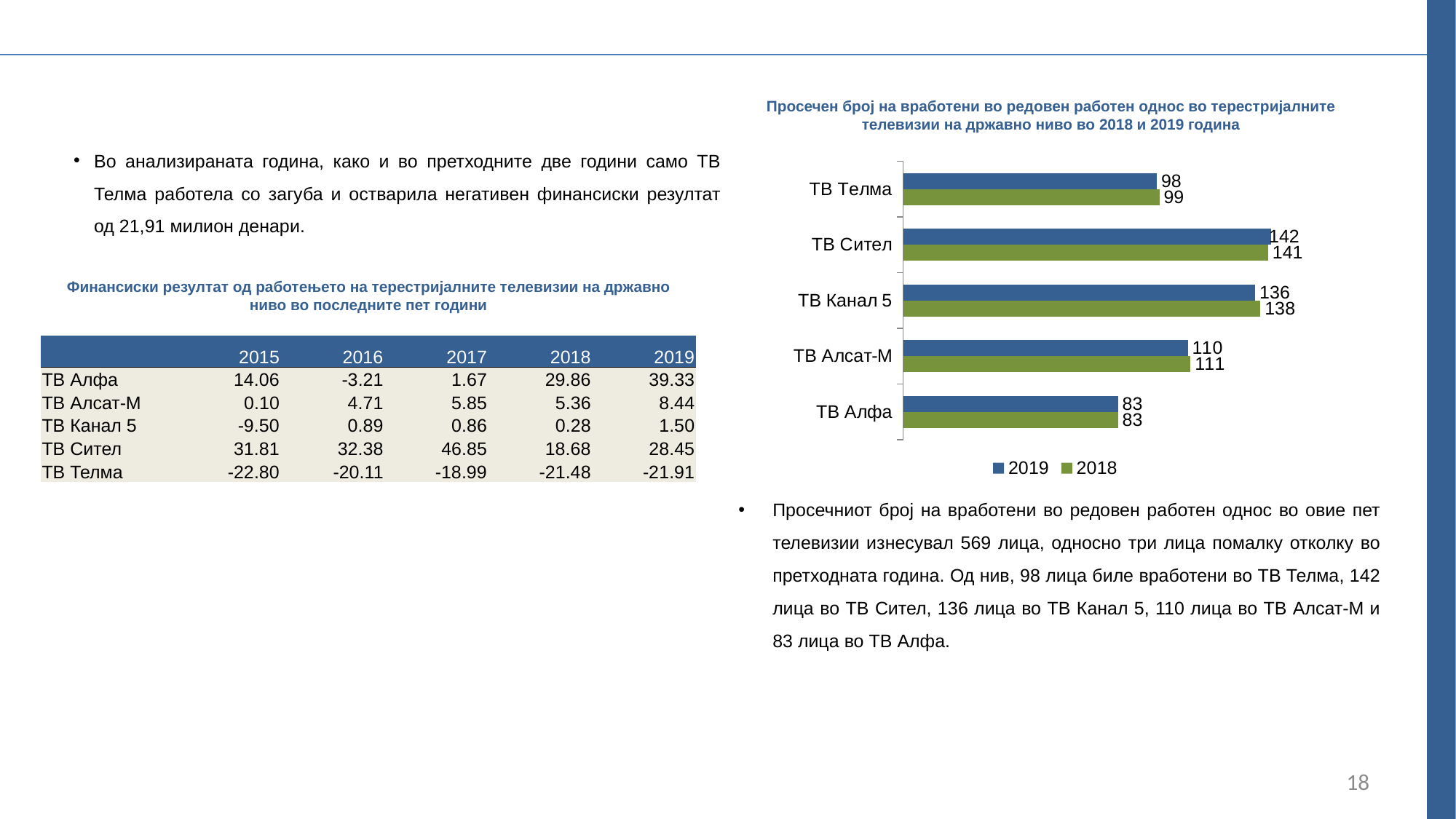
What is the value for ТВ Канал 5 in 2018? 138 What is the value for ТВ Сител in 2019? 142 Which colour represents the 2018 series in the chart? Green What is the difference between the 2019 values for ТВ Сител and ТВ Алфа? 59 What is the value for ТВ Алсат-М in 2019? 110 How many television stations are shown in the chart? 5 Which television station has the highest value in 2019? ТВ Сител Which is larger for ТВ Канал 5: the 2018 value or the 2019 value? 2018 How many series does the chart legend list? 2 Which television station has the lowest value in 2018? ТВ Алфа What type of chart is shown on the slide? Bar chart What is the value for ТВ Телма in 2018? 99